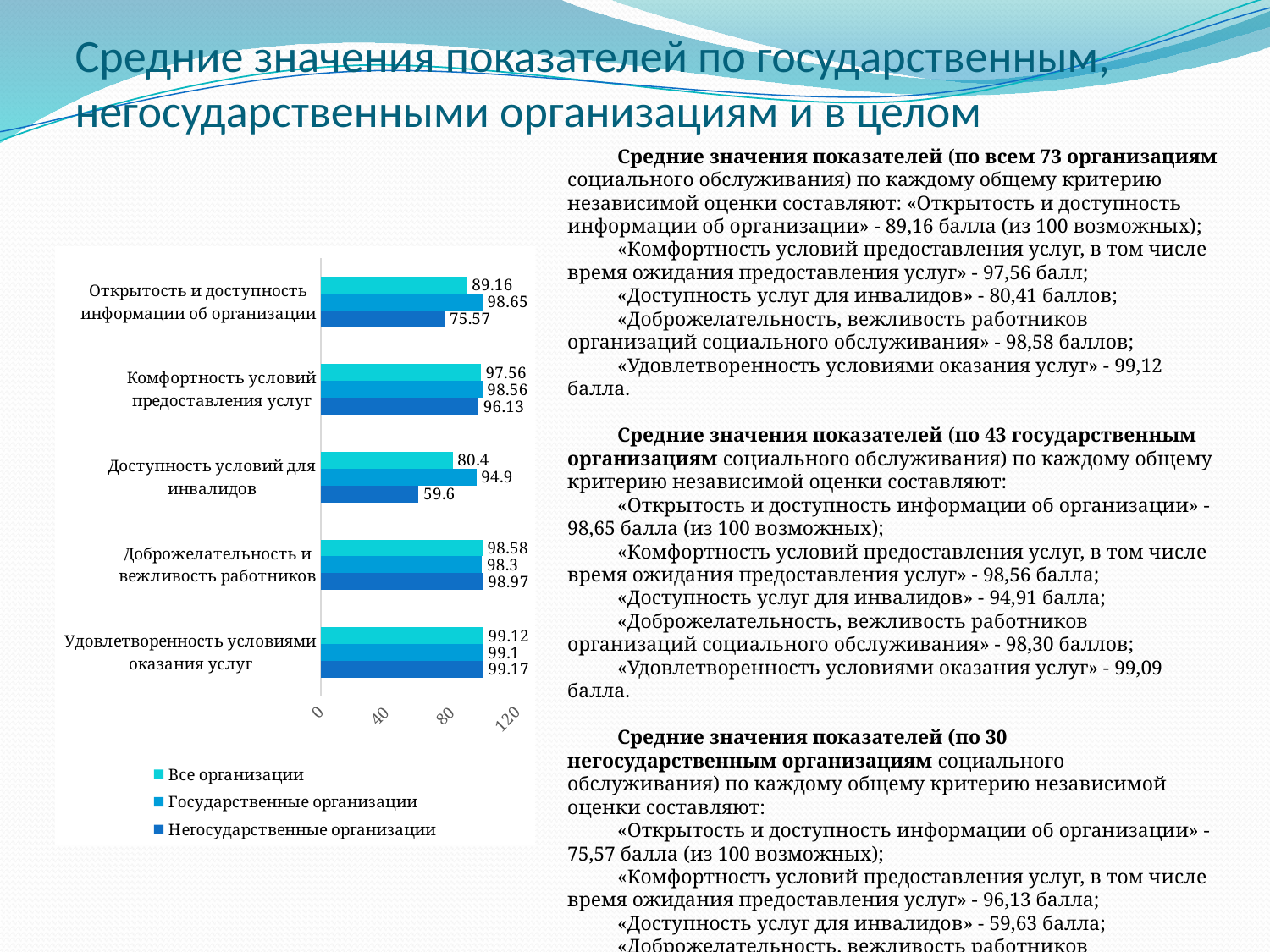
How many series does the legend list? 3 What is the last entry in the chart legend? Негосударственные организации Which category has the lowest value for «Негосударственные организации»? Доступность условий для инвалидов What is the difference between «Государственные организации» and «Негосударственные организации» in the category «Доступность условий для инвалидов»? 35.3 What is the value for «Негосударственные организации» in the category «Доступность условий для инвалидов»? 59.6 What is the value for «Все организации» in the category «Открытость и доступность информации об организации»? 89.16 What kind of chart is shown on the slide? Bar chart In the category «Открытость и доступность информации об организации», which is larger: «Государственные организации» or «Негосударственные организации»? Государственные организации Which category has the highest value for «Все организации»? Удовлетворенность условиями оказания услуг How many categories are shown on the chart? 5 Is the value for «Все организации» in «Доступность условий для инвалидов» greater or less than 80? greater What is the value for «Государственные организации» in the category «Комфортность условий предоставления услуг»? 98.56